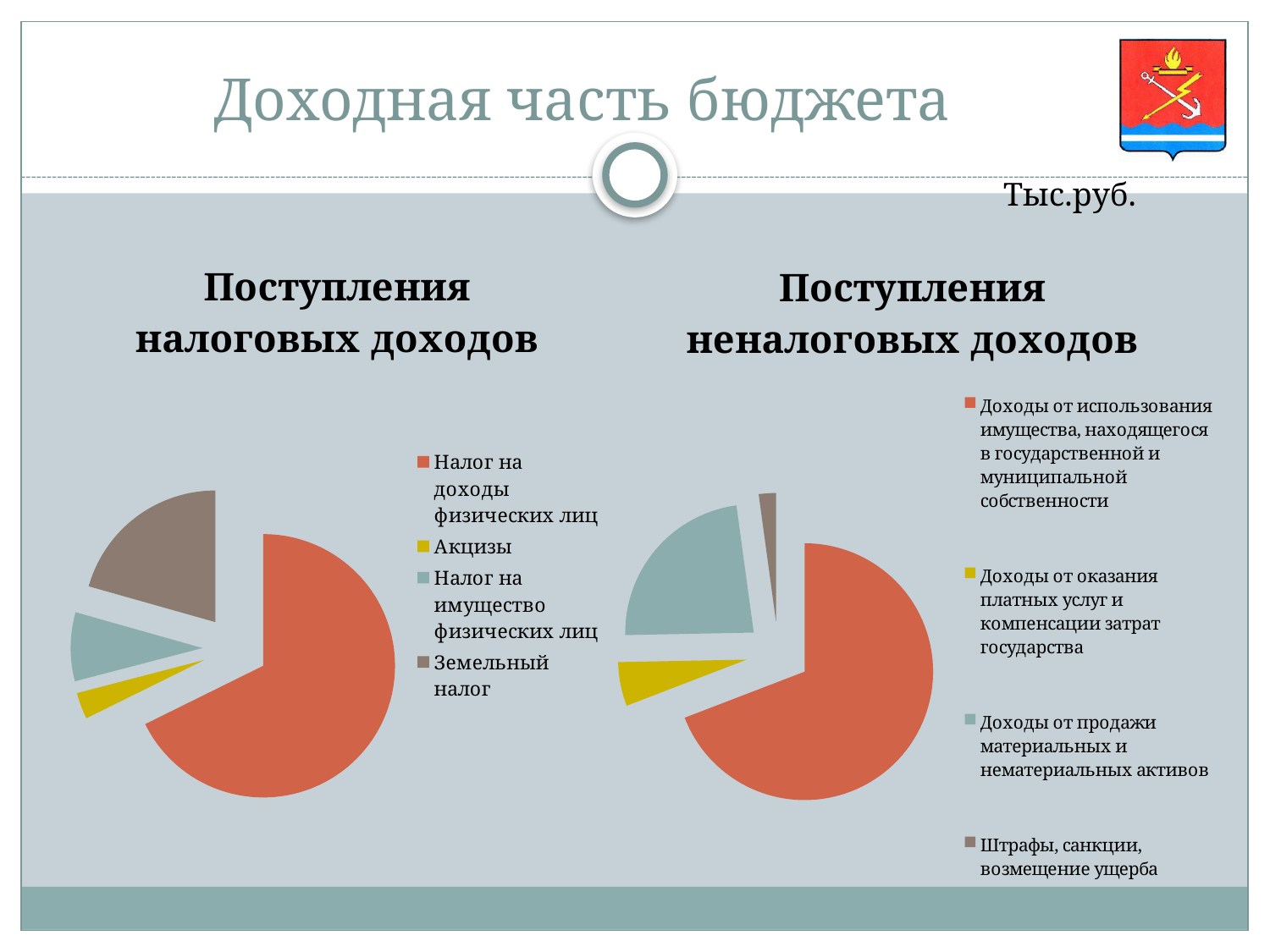
In the chart "Поступления неналоговых доходов", which category has the smallest slice? Штрафы, санкции, возмещение ущерба In the chart "Поступления налоговых доходов", which is larger: Земельный налог or Налог на имущество физических лиц? Земельный налог In the chart "Поступления неналоговых доходов", how many categories does the legend list? 4 What kind of chart is the chart titled "Поступления неналоговых доходов"? pie chart What is the title of the pie chart on the left side of the slide? Поступления налоговых доходов In the chart "Поступления налоговых доходов", what colour is the slice for Акцизы? yellow In the chart "Поступления налоговых доходов", which category has the smallest slice? Акцизы What kind of chart is the chart titled "Поступления налоговых доходов"? pie chart In the chart "Поступления неналоговых доходов", which is larger: Доходы от продажи материальных и нематериальных активов or Доходы от оказания платных услуг и компенсации затрат государства? Доходы от продажи материальных и нематериальных активов In the chart "Поступления налоговых доходов", how many slices does the pie have? 4 In the chart "Поступления неналоговых доходов", which category has the largest slice? Доходы от использования имущества, находящегося в государственной и муниципальной собственности In the chart "Поступления налоговых доходов", which category has the largest slice? Налог на доходы физических лиц